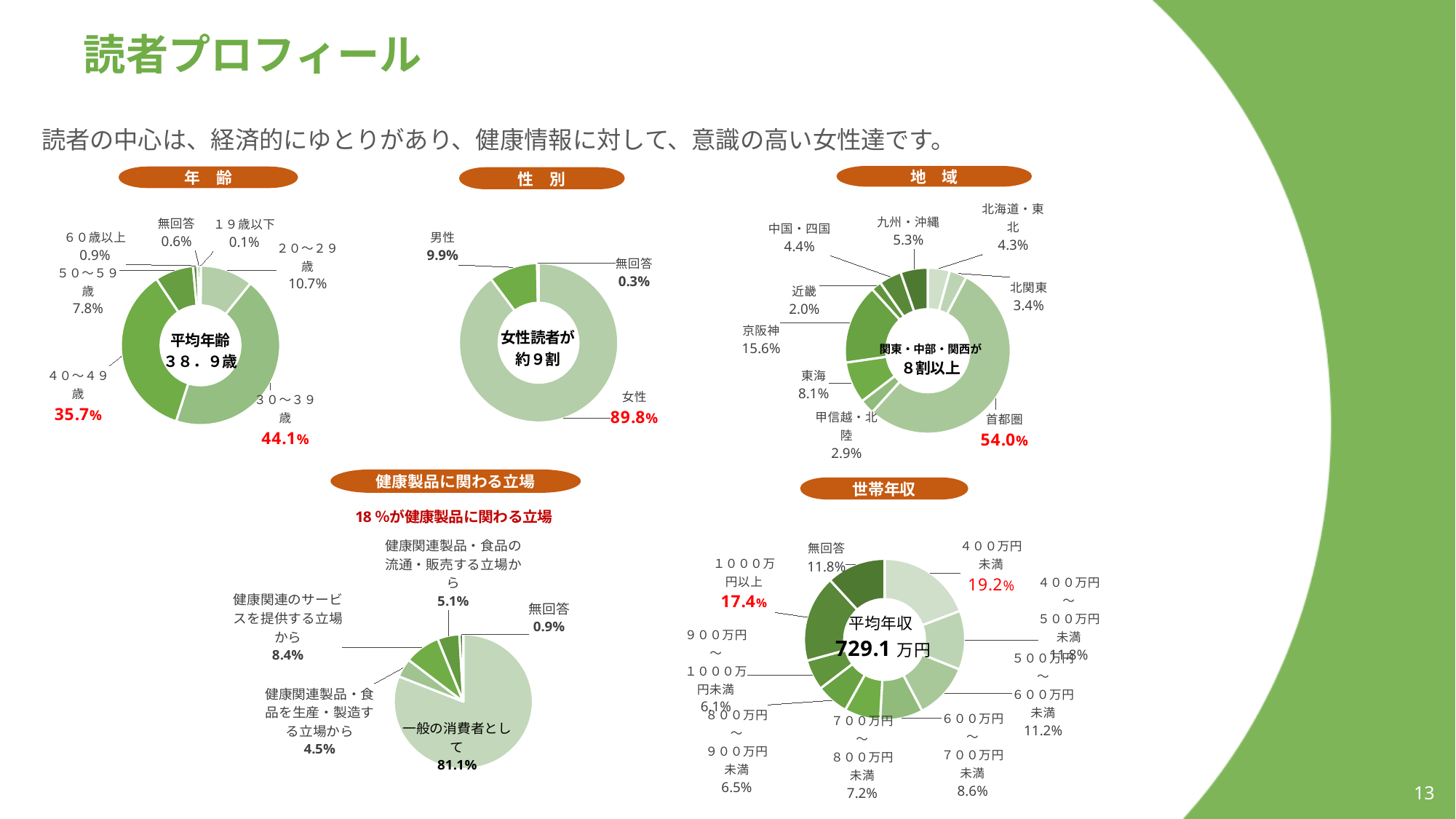
What type of chart is used for the 世帯年収 data? Donut (pie) chart In the 年齢 chart, which age group has the largest share? 30〜39歳 In the 地域 chart, what is the share for 首都圏? 54.0% In the 年齢 chart, what percentage of readers are 30〜39歳? 44.1% In the 世帯年収 chart, what is the share for １０００万円以上? 17.4% How many categories does the 健康製品に関わる立場 chart show? 5 In the 健康製品に関わる立場 chart, what is the share for 一般の消費者として? 81.1% In the 地域 chart, which is larger: 京阪神 or 東海? 京阪神 In the 年齢 chart, what is the difference between the 30〜39歳 and 40〜49歳 shares? 8.4% How many categories does the 性別 chart show? 3 In the 地域 chart, which region has the smallest share? 近畿 In the 性別 chart, what percentage of readers are 女性? 89.8%